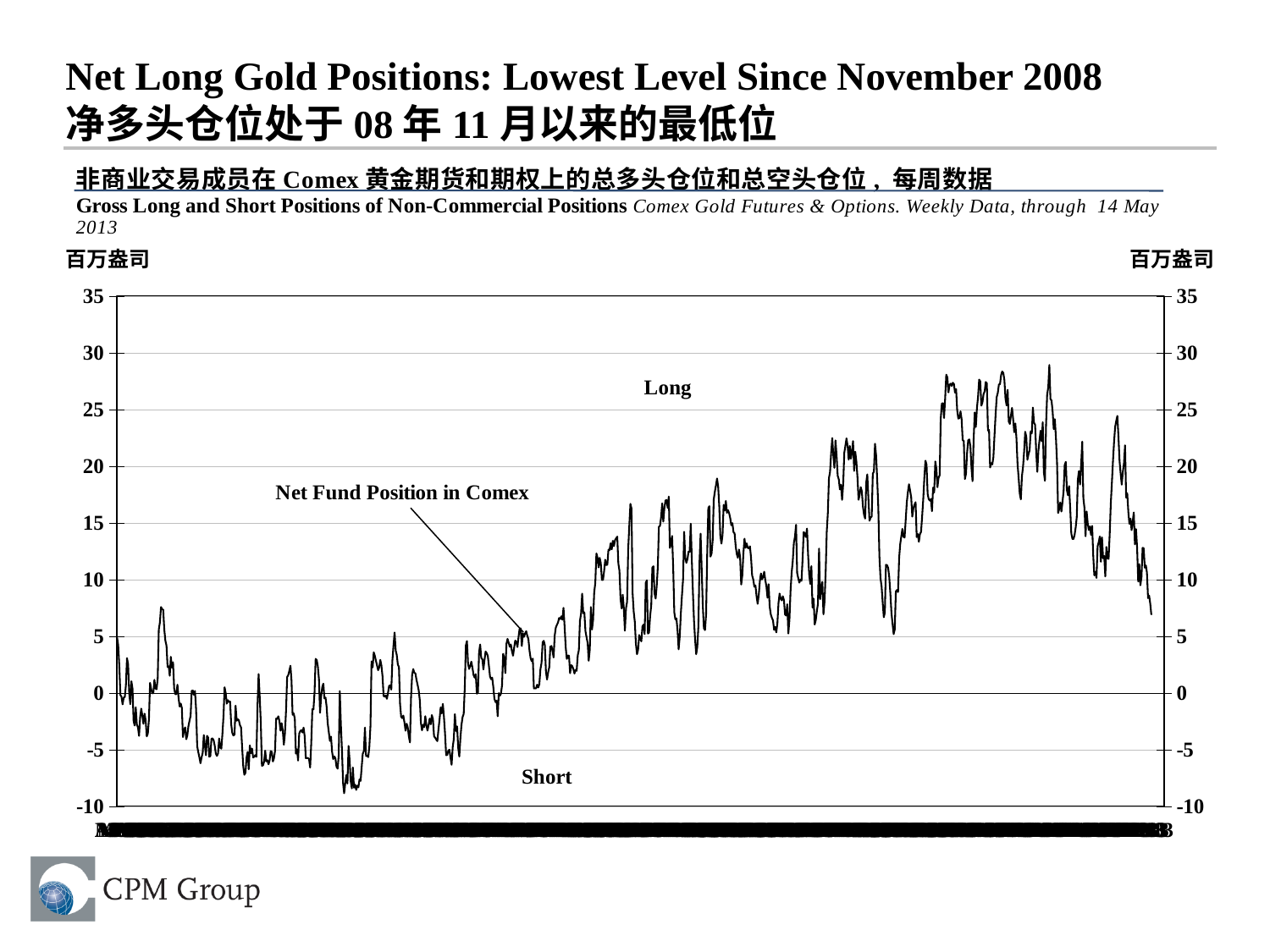
What is the lowest value shown on the vertical axis of the chart? -10 Is the lowest point of the line greater or less than -5? less Is the highest peak of the line greater or less than 25? greater What is the highest value shown on the left vertical axis of the chart? 35 What is the name of the series plotted on the chart, as labelled on the chart? Net Fund Position in Comex What kind of chart is shown on the slide? line chart Does the line end higher or lower than it starts? higher Which label is placed in the upper part of the chart area, above the zero line: Long or Short? Long Overall, does the Net Fund Position in Comex line rise or fall from the left side of the chart to the right side? rise